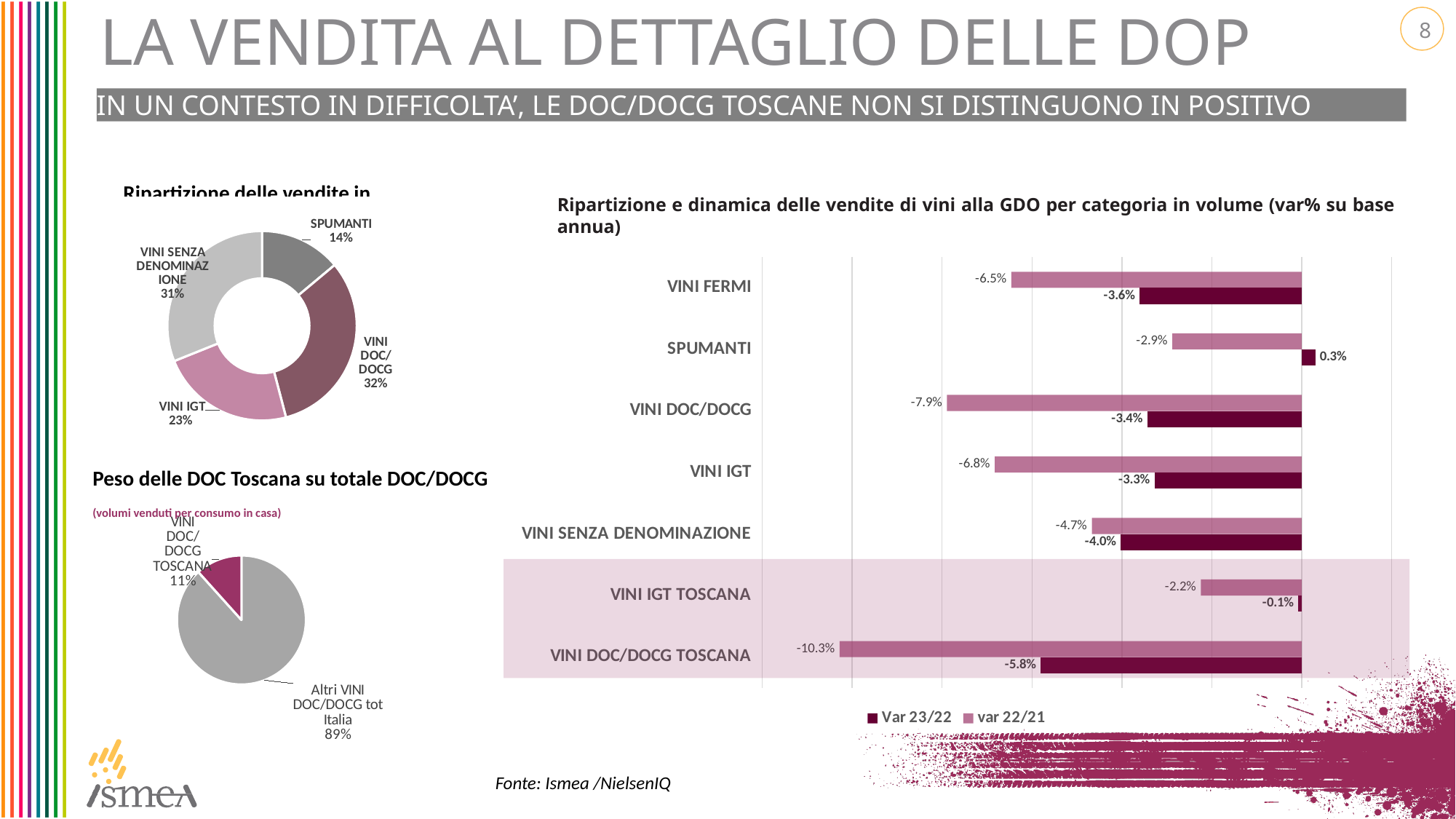
In the chart 'Ripartizione e dinamica delle vendite di vini alla GDO per categoria in volume', what is the var 22/21 value for SPUMANTI? -2.9% In the donut chart at the top left of the slide, what share do VINI DOC/DOCG have? 32% In the donut chart at the top left of the slide, how many categories are shown? 4 In the pie chart 'Peso delle DOC Toscana su totale DOC/DOCG', what share do VINI DOC/DOCG TOSCANA have? 11% In the chart 'Ripartizione e dinamica delle vendite di vini alla GDO per categoria in volume', how many series does the legend list? 2 In the chart 'Ripartizione e dinamica delle vendite di vini alla GDO per categoria in volume', what is the Var 23/22 value for VINI DOC/DOCG TOSCANA? -5.8% What type of chart is 'Ripartizione e dinamica delle vendite di vini alla GDO per categoria in volume'? Bar chart In the pie chart 'Peso delle DOC Toscana su totale DOC/DOCG', what is the difference between the share of Altri VINI DOC/DOCG tot Italia and that of VINI DOC/DOCG TOSCANA? 78% In the chart 'Ripartizione e dinamica delle vendite di vini alla GDO per categoria in volume', which category has the highest Var 23/22 value? SPUMANTI In the chart 'Ripartizione e dinamica delle vendite di vini alla GDO per categoria in volume', what is the difference between the var 22/21 and Var 23/22 values for VINI IGT? 3.5 percentage points In the donut chart at the top left of the slide, which category has the smallest share? SPUMANTI In the chart 'Ripartizione e dinamica delle vendite di vini alla GDO per categoria in volume', which category has the lowest var 22/21 value? VINI DOC/DOCG TOSCANA